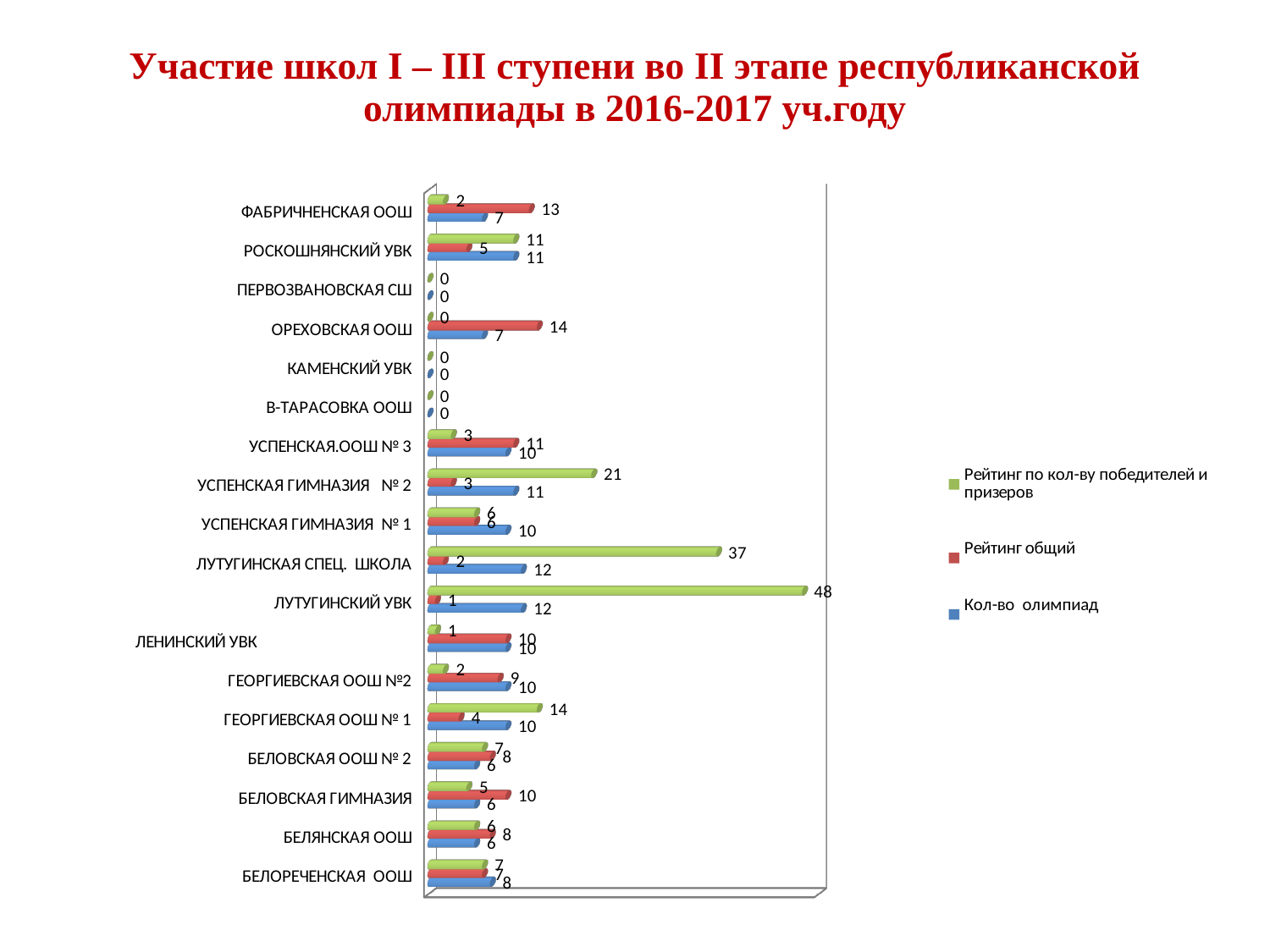
What is the value of 'Рейтинг общий' for ОРЕХОВСКАЯ ООШ? 14 What is the value of 'Рейтинг по кол-ву победителей и призеров' for ЛУТУГИНСКИЙ УВК? 48 How many schools (categories) are shown on the chart? 18 Which colour represents the series 'Кол-во олимпиад' in the legend? blue What is the difference between the 'Рейтинг по кол-ву победителей и призеров' values of ЛУТУГИНСКИЙ УВК and ЛУТУГИНСКАЯ СПЕЦ. ШКОЛА? 11 Which school has the highest value for 'Рейтинг по кол-ву победителей и призеров'? ЛУТУГИНСКИЙ УВК Which is larger: the 'Рейтинг общий' value for ФАБРИЧНЕНСКАЯ ООШ or for РОСКОШНЯНСКИЙ УВК? ФАБРИЧНЕНСКАЯ ООШ How many series does the legend list? 3 What kind of chart is shown on the slide? bar chart What is the value of 'Кол-во олимпиад' for ЛУТУГИНСКАЯ СПЕЦ. ШКОЛА? 12 Which school has the highest value for 'Рейтинг общий'? ОРЕХОВСКАЯ ООШ What is the value of 'Рейтинг по кол-ву победителей и призеров' for УСПЕНСКАЯ ГИМНАЗИЯ № 2? 21